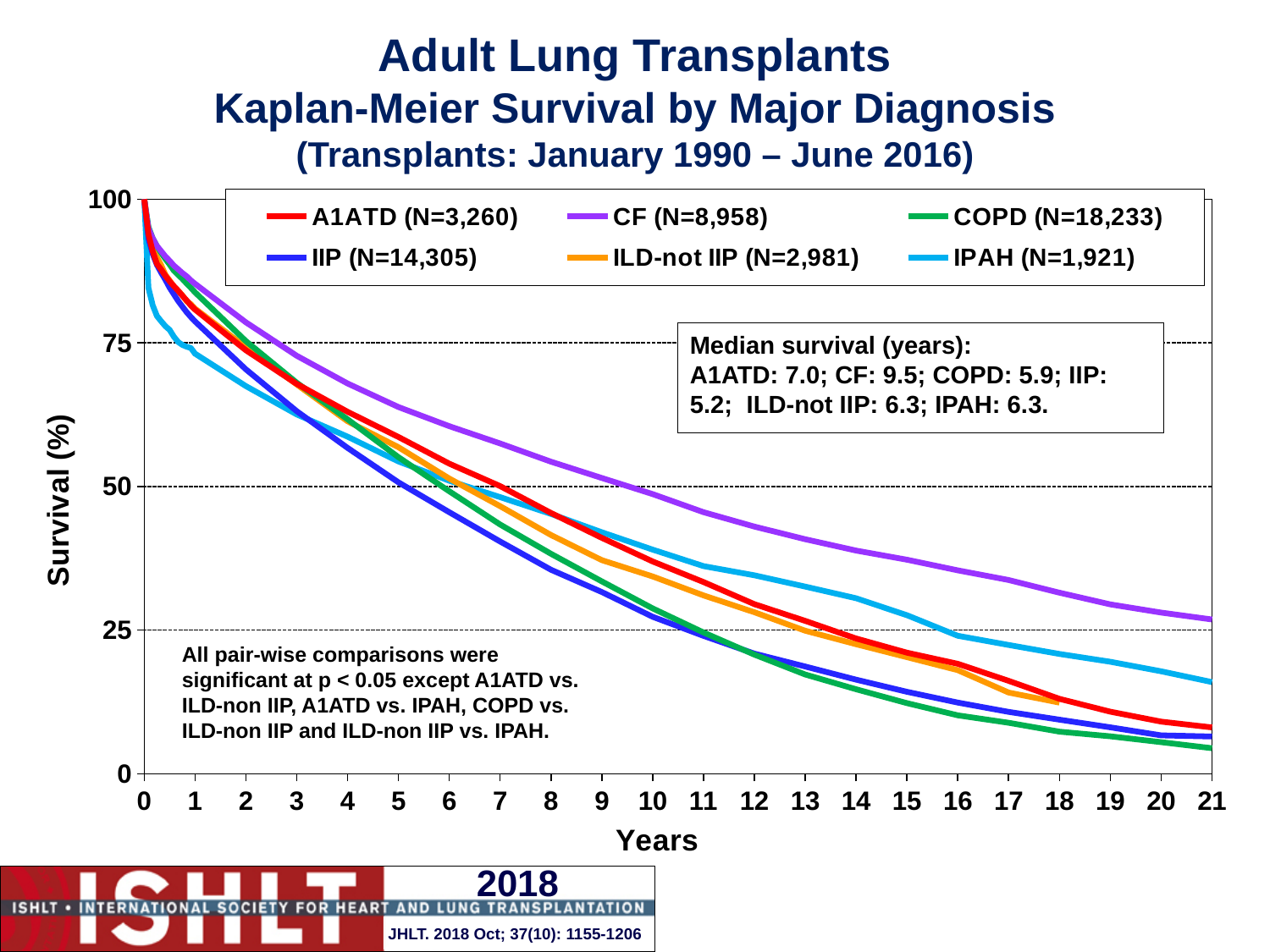
What is the median survival in years for IIP? 5.2 What is the N for the COPD group shown in the legend? 18,233 Which has the larger median survival, A1ATD or COPD? A1ATD How many series does the legend list? 6 Which diagnosis group has the highest median survival? CF What is the median survival in years for CF? 9.5 What type of chart is shown on the slide? line chart Which diagnosis group has the lowest median survival? IIP Is the survival value for COPD at 15 years greater or less than 25? less Do the survival curves rise or fall as years increase? fall What is the difference in median survival (years) between CF and IIP? 4.3 Is the survival value for CF at 21 years greater or less than 25? greater